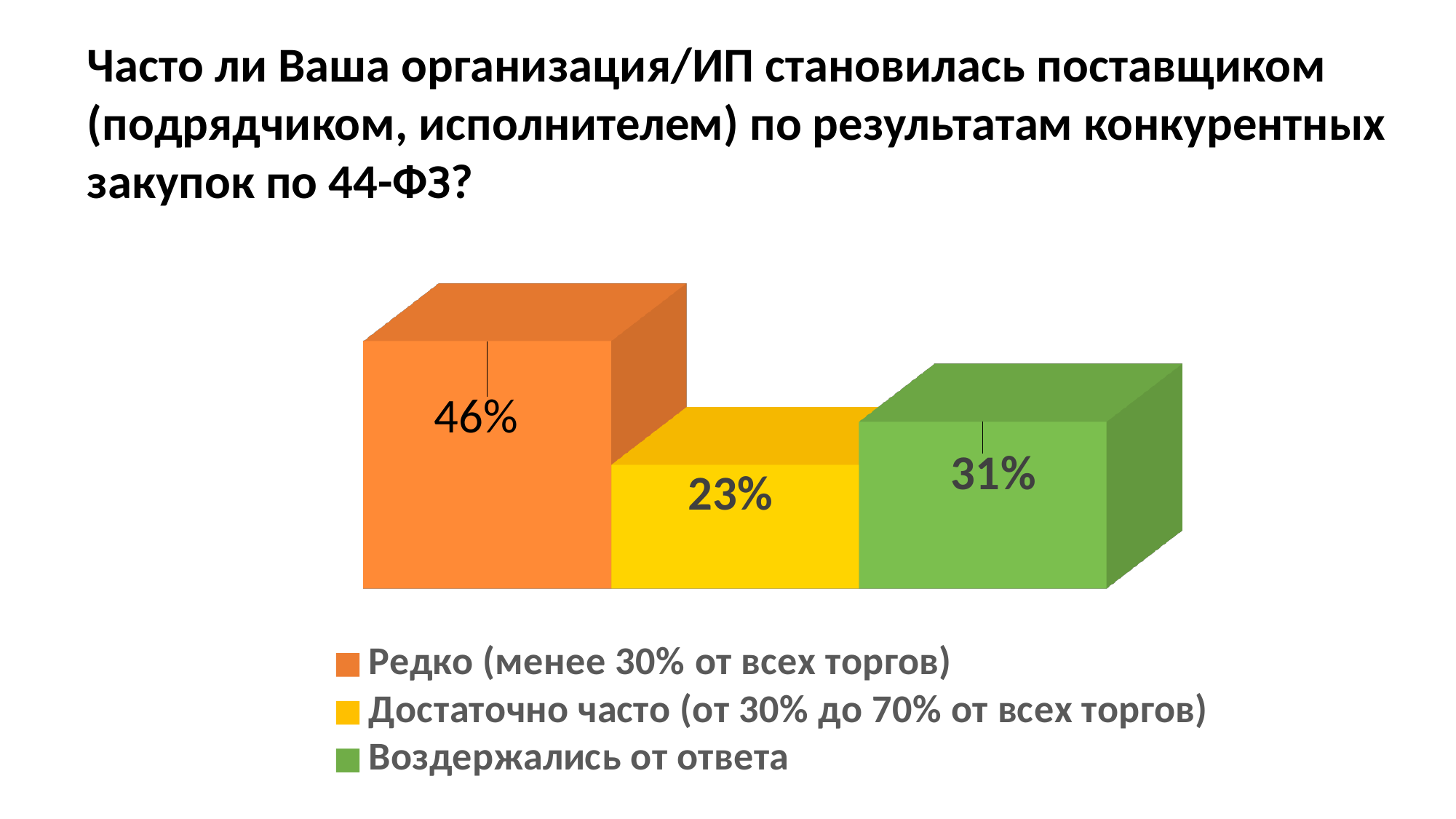
How many entries does the legend list? 3 Which category has the lowest value? Достаточно часто (от 30% до 70% от всех торгов) What percentage is shown for "Воздержались от ответа"? 31% What percentage is shown for "Редко (менее 30% от всех торгов)"? 46% What kind of chart is shown on the slide? Bar chart What percentage is shown for "Достаточно часто (от 30% до 70% от всех торгов)"? 23% How many bars are plotted in the chart? 3 What is the difference between the values for "Редко" and "Достаточно часто"? 23% What colour is the bar for "Воздержались от ответа"? Green Which is larger: the value for "Воздержались от ответа" or for "Достаточно часто"? Воздержались от ответа Which category has the highest value? Редко (менее 30% от всех торгов) What is the difference between the values for "Воздержались от ответа" and "Достаточно часто"? 8%